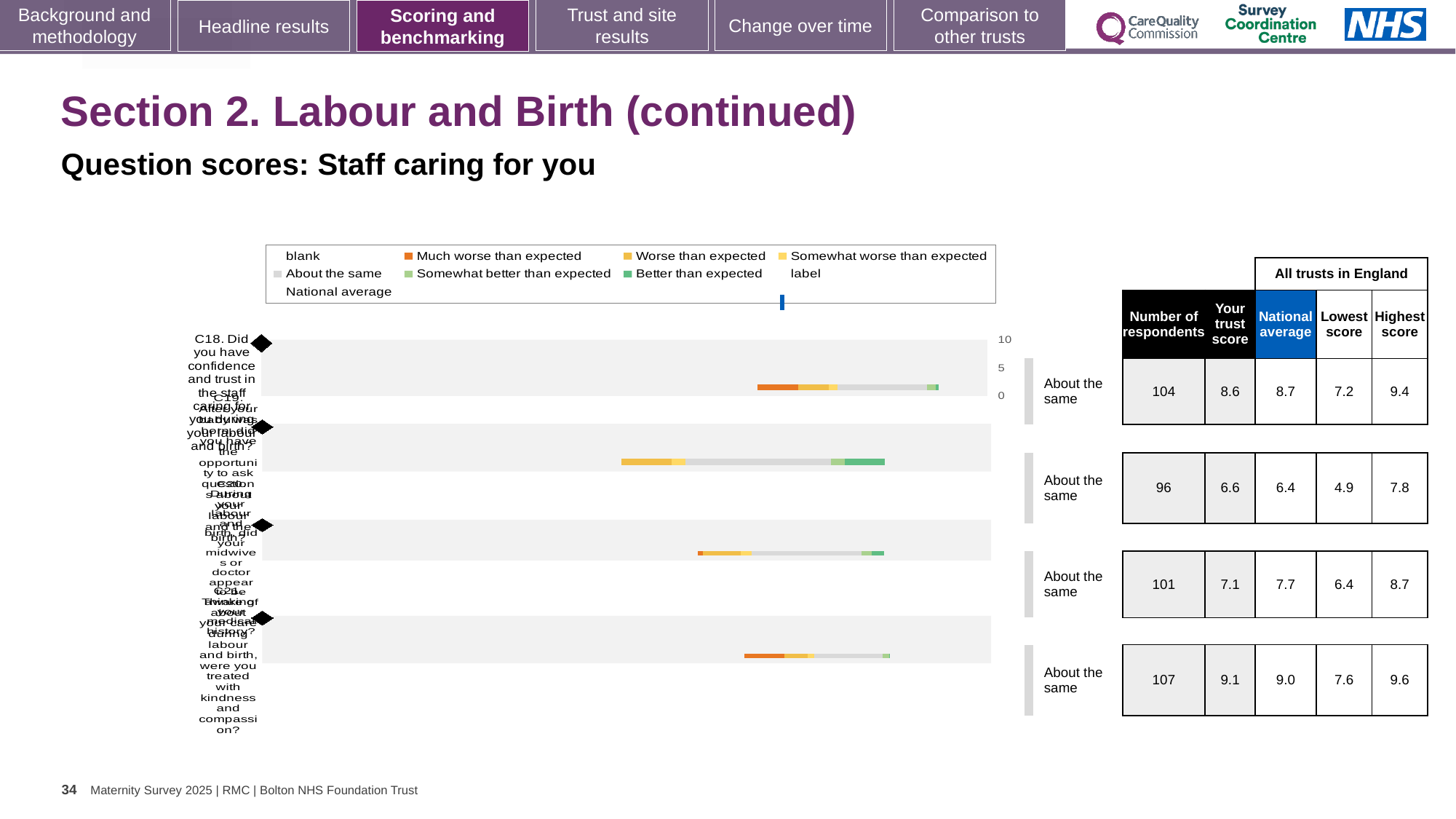
What is the highest value shown on the chart's axis? 10 In the table beside the chart, which row has the highest 'Your trust score'? the fourth row (C21), 9.1 What benchmark label is shown next to the C18 bar (first row)? About the same In the table beside the chart, which row has the lowest 'Your trust score'? the second row (C19), 6.6 In the table beside the chart, what is the 'Your trust score' for the first row (C18)? 8.6 What colour represents 'Better than expected' in the chart legend? green In the table beside the chart, is the 'Your trust score' for the third row (C20) larger or smaller than its national average? smaller What colour represents 'Much worse than expected' in the chart legend? orange What kind of chart is shown on the slide? bar chart How many question rows (bars) are plotted in the chart? 4 In the table beside the chart, what is the national average for the second row (C19)? 6.4 In the table beside the chart, what is the difference between the highest score and lowest score for the first row (C18)? 2.2